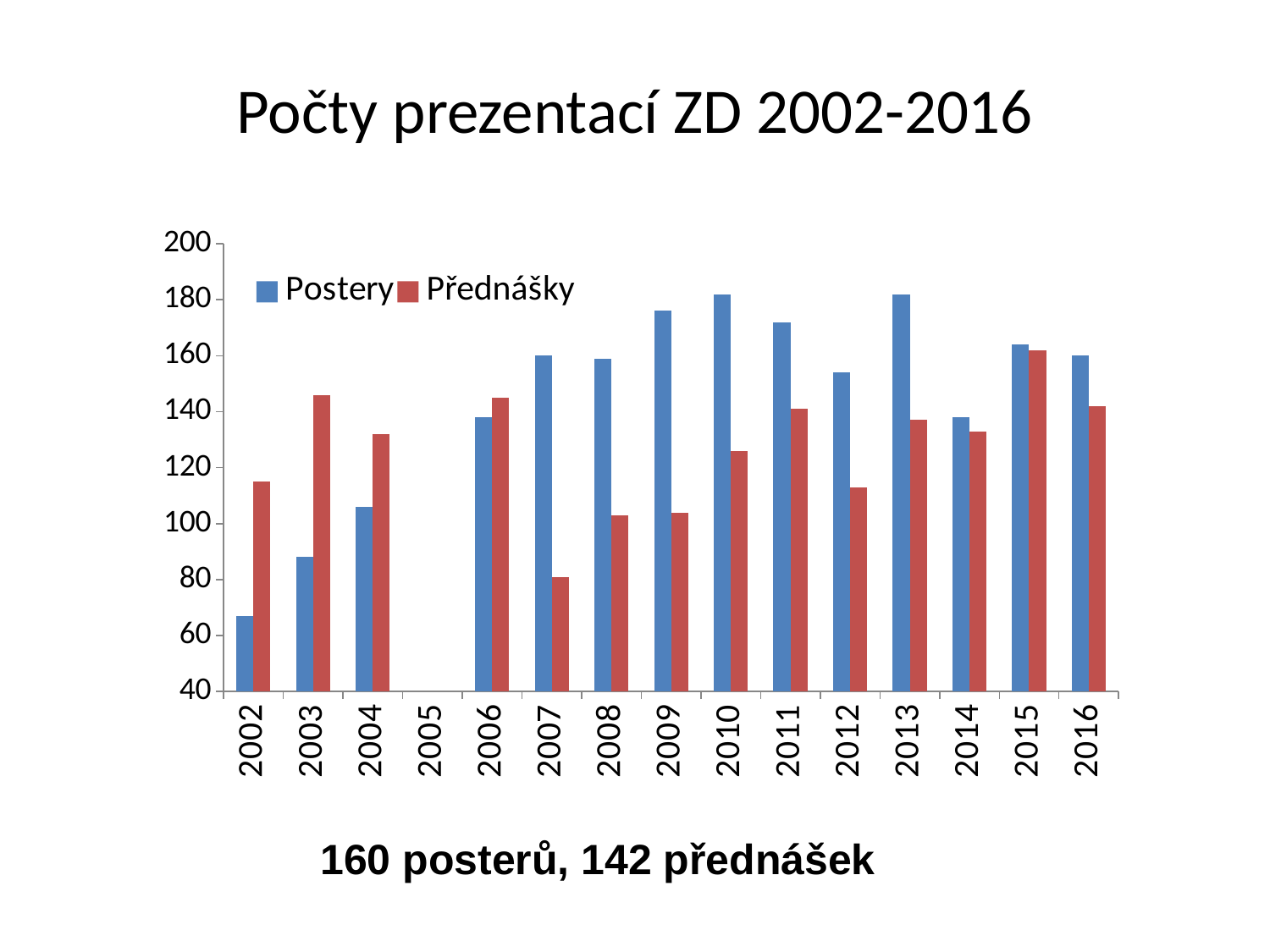
In 2009, which series has the larger value, Postery or Přednášky? Postery What is the value for Přednášky in 2016? 142 How many years are labelled on the x axis? 15 What is the title of the chart? Počty prezentací ZD 2002-2016 What is the value for Postery in 2016? 160 Is the value for Postery in 2002 greater or less than 80? less What kind of chart is shown on the slide? bar chart How many series does the legend list? 2 Which year has the lowest value for Postery? 2002 Which year has the highest value for Přednášky? 2015 Is the value for Přednášky in 2003 greater or less than 140? greater Which year has the lowest value for Přednášky? 2007